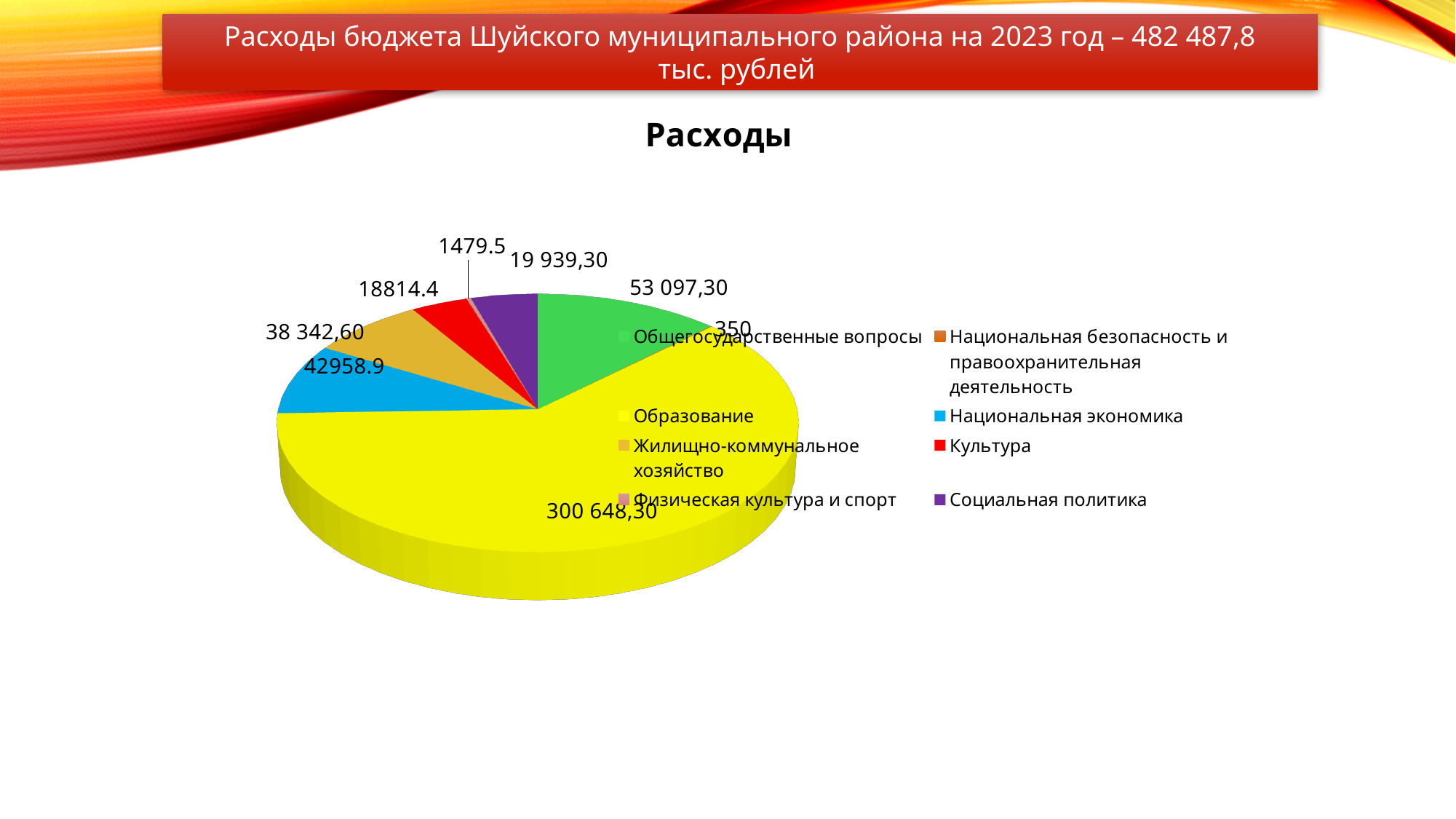
What is the value for Общегосударственные вопросы? 53 097,30 What is the value for Социальная политика? 19 939,30 What is the value for Культура? 18814.4 What is the value for Образование? 300 648,30 What is the difference between the values for Общегосударственные вопросы and Жилищно-коммунальное хозяйство? 14 754,70 What is the value for Национальная безопасность и правоохранительная деятельность? 350 Which category has the smallest value? Национальная безопасность и правоохранительная деятельность How many categories does the legend list? 8 What is the value for Жилищно-коммунальное хозяйство? 38 342,60 Which category has the largest slice of the pie? Образование What kind of chart is shown on the slide? pie chart What is the value for Национальная экономика? 42958.9